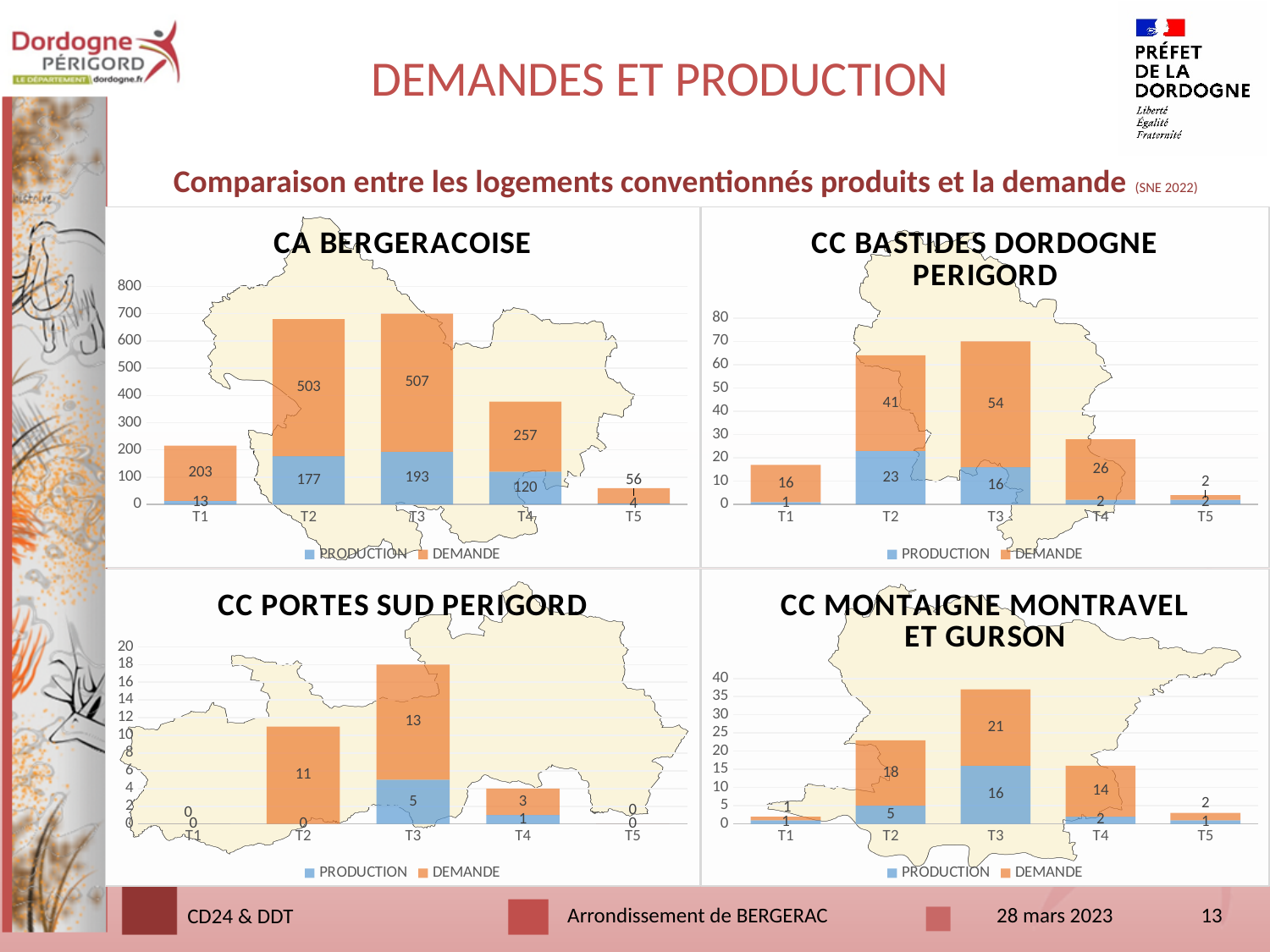
In the CC MONTAIGNE MONTRAVEL ET GURSON chart, is the PRODUCTION value for T3 larger or smaller than the DEMANDE value for T4? larger In the CC BASTIDES DORDOGNE PERIGORD chart, what is the DEMANDE value for T3? 54 In the CC PORTES SUD PERIGORD chart, what is the total of the stacked bar for T3? 18 In the CA BERGERACOISE chart, which category has the highest DEMANDE value? T3 In the CC BASTIDES DORDOGNE PERIGORD chart, which category has the highest PRODUCTION value? T2 In the CC BASTIDES DORDOGNE PERIGORD chart, what is the difference between the DEMANDE values for T3 and T2? 13 In the CC PORTES SUD PERIGORD chart, what is the DEMANDE value for T2? 11 In the CA BERGERACOISE chart, what is the total of the stacked bar for T4? 377 What kind of chart is the CC PORTES SUD PERIGORD chart? stacked bar chart In the CA BERGERACOISE chart, what is the DEMANDE value for T3? 507 How many series does the legend of the CC MONTAIGNE MONTRAVEL ET GURSON chart list? 2 In the CA BERGERACOISE chart, what is the PRODUCTION value for T2? 177